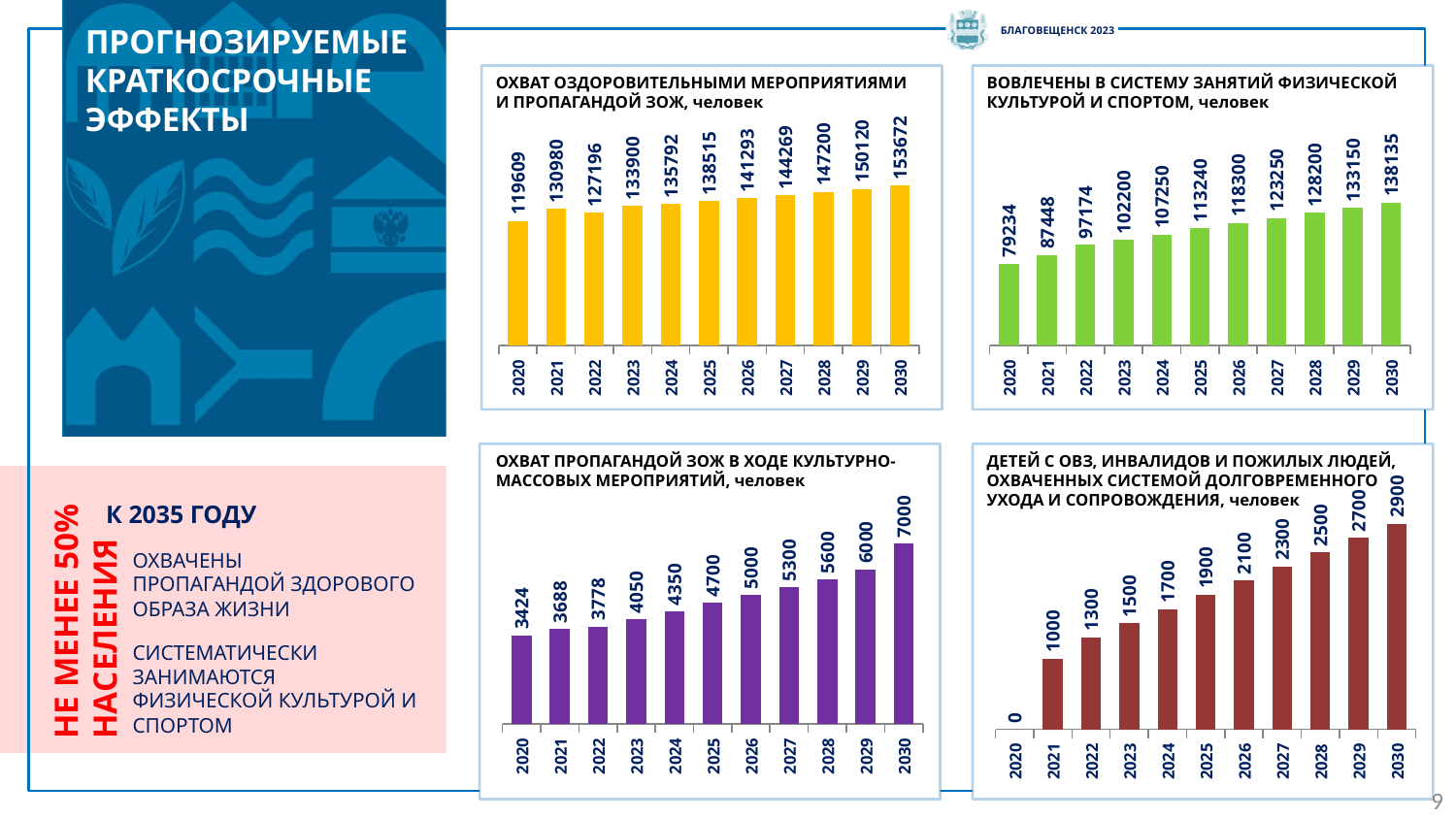
What type of chart is the bottom-right chart (ДЕТЕЙ С ОВЗ, ИНВАЛИДОВ И ПОЖИЛЫХ ЛЮДЕЙ)? bar chart In the bottom-left chart (ОХВАТ ПРОПАГАНДОЙ ЗОЖ В ХОДЕ КУЛЬТУРНО-МАССОВЫХ МЕРОПРИЯТИЙ), do the values rise or fall from 2020 to 2030? rise In the bottom-left chart (ОХВАТ ПРОПАГАНДОЙ ЗОЖ В ХОДЕ КУЛЬТУРНО-МАССОВЫХ МЕРОПРИЯТИЙ), what is the difference between the values for 2030 and 2029? 1000 In the top-left chart (ОХВАТ ОЗДОРОВИТЕЛЬНЫМИ МЕРОПРИЯТИЯМИ И ПРОПАГАНДОЙ ЗОЖ), which year has the highest value? 2030 In the top-right chart (ВОВЛЕЧЕНЫ В СИСТЕМУ ЗАНЯТИЙ ФИЗИЧЕСКОЙ КУЛЬТУРОЙ И СПОРТОМ), what is the value for 2025? 113240 In the top-left chart (ОХВАТ ОЗДОРОВИТЕЛЬНЫМИ МЕРОПРИЯТИЯМИ И ПРОПАГАНДОЙ ЗОЖ), what is the value for 2020? 119609 In the top-right chart (ВОВЛЕЧЕНЫ В СИСТЕМУ ЗАНЯТИЙ ФИЗИЧЕСКОЙ КУЛЬТУРОЙ И СПОРТОМ), what is the difference between the values for 2030 and 2020? 58901 In the bottom-right chart (ДЕТЕЙ С ОВЗ, ИНВАЛИДОВ И ПОЖИЛЫХ ЛЮДЕЙ), how many years are shown on the x axis? 11 In the top-left chart (ОХВАТ ОЗДОРОВИТЕЛЬНЫМИ МЕРОПРИЯТИЯМИ И ПРОПАГАНДОЙ ЗОЖ), which is larger, the value for 2021 or the value for 2022? 2021 In the bottom-left chart (ОХВАТ ПРОПАГАНДОЙ ЗОЖ В ХОДЕ КУЛЬТУРНО-МАССОВЫХ МЕРОПРИЯТИЙ), what is the value for 2024? 4350 In the bottom-right chart (ДЕТЕЙ С ОВЗ, ИНВАЛИДОВ И ПОЖИЛЫХ ЛЮДЕЙ), what is the value for 2021? 1000 In the top-right chart (ВОВЛЕЧЕНЫ В СИСТЕМУ ЗАНЯТИЙ ФИЗИЧЕСКОЙ КУЛЬТУРОЙ И СПОРТОМ), which year has the lowest value? 2020